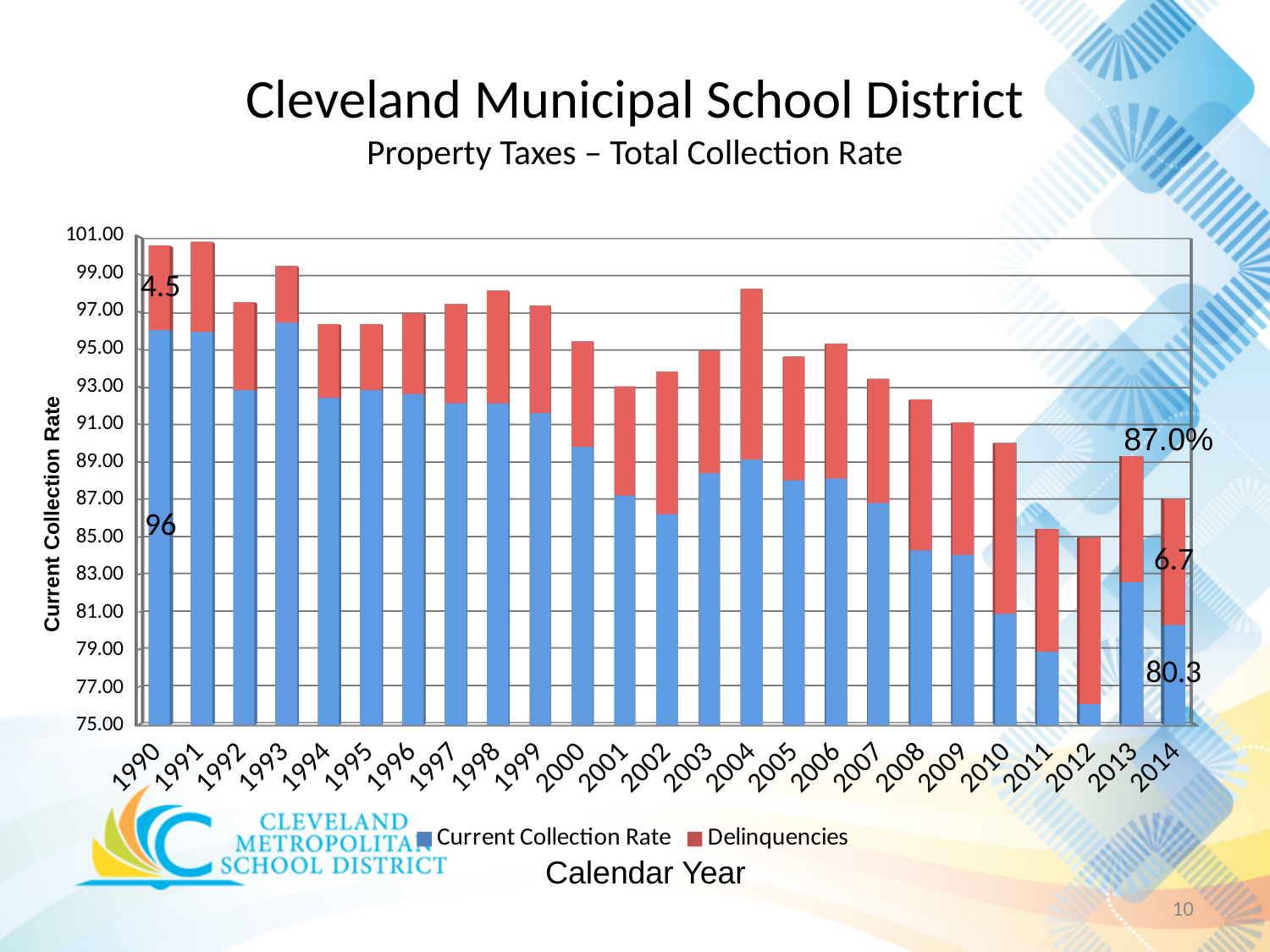
What is the total collection rate labelled for 2014? 87.0% What is the Current Collection Rate for 1990? 96 What is the Delinquencies value for 2014? 6.7 Which year has the lowest Current Collection Rate? 2012 Is the Current Collection Rate for 2012 greater or less than 77.00? less How many series does the legend list? 2 Is the Current Collection Rate for 1993 greater or less than 95.00? greater What kind of chart is shown on the slide? Stacked bar chart By how much is the Current Collection Rate for 1990 higher than for 2014? 15.7 What is the Delinquencies value for 1990? 4.5 What is the Current Collection Rate for 2014? 80.3 How many calendar years are shown on the x axis? 25